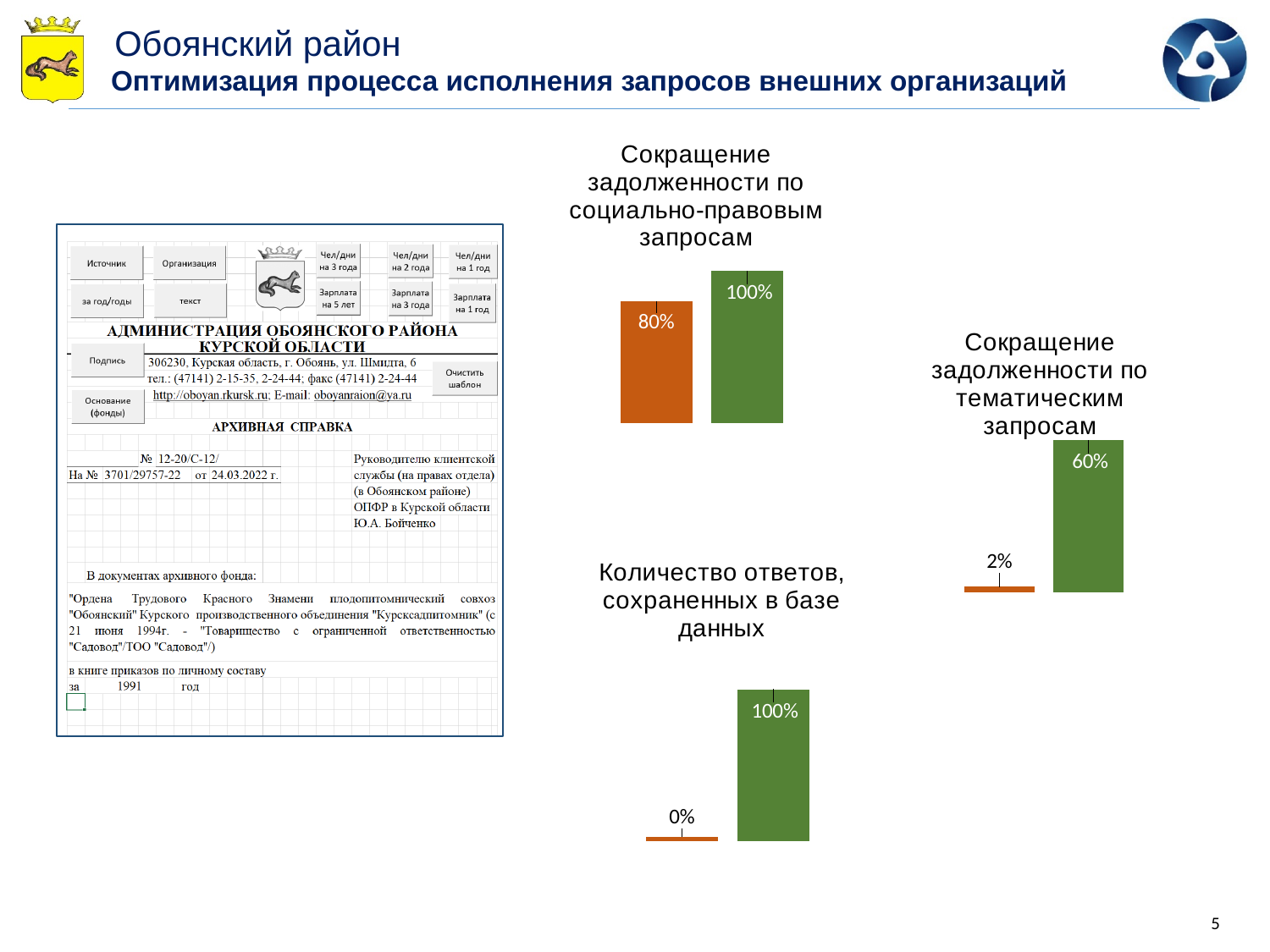
In the chart titled 'Сокращение задолженности по социально-правовым запросам', what is the difference between the green bar and the orange bar? 20% In the chart titled 'Сокращение задолженности по тематическим запросам', what value is shown on the orange (left) bar? 2% In the chart titled 'Сокращение задолженности по социально-правовым запросам', what value is shown on the orange (left) bar? 80% In the chart titled 'Сокращение задолженности по социально-правовым запросам', what value is shown on the green (right) bar? 100% In the chart titled 'Сокращение задолженности по тематическим запросам', what is the difference between the green bar and the orange bar? 58% In the chart titled 'Сокращение задолженности по тематическим запросам', which bar is higher, the orange one or the green one? the green one In the chart titled 'Количество ответов, сохраненных в базе данных', what value is shown on the green (right) bar? 100% In the chart titled 'Сокращение задолженности по тематическим запросам', what value is shown on the green (right) bar? 60% What kind of chart is the one titled 'Сокращение задолженности по социально-правовым запросам'? bar chart How many charts are shown on the slide? 3 In the chart titled 'Количество ответов, сохраненных в базе данных', what value is shown on the orange (left) bar? 0% In the chart titled 'Количество ответов, сохраненных в базе данных', how many bars are plotted? 2